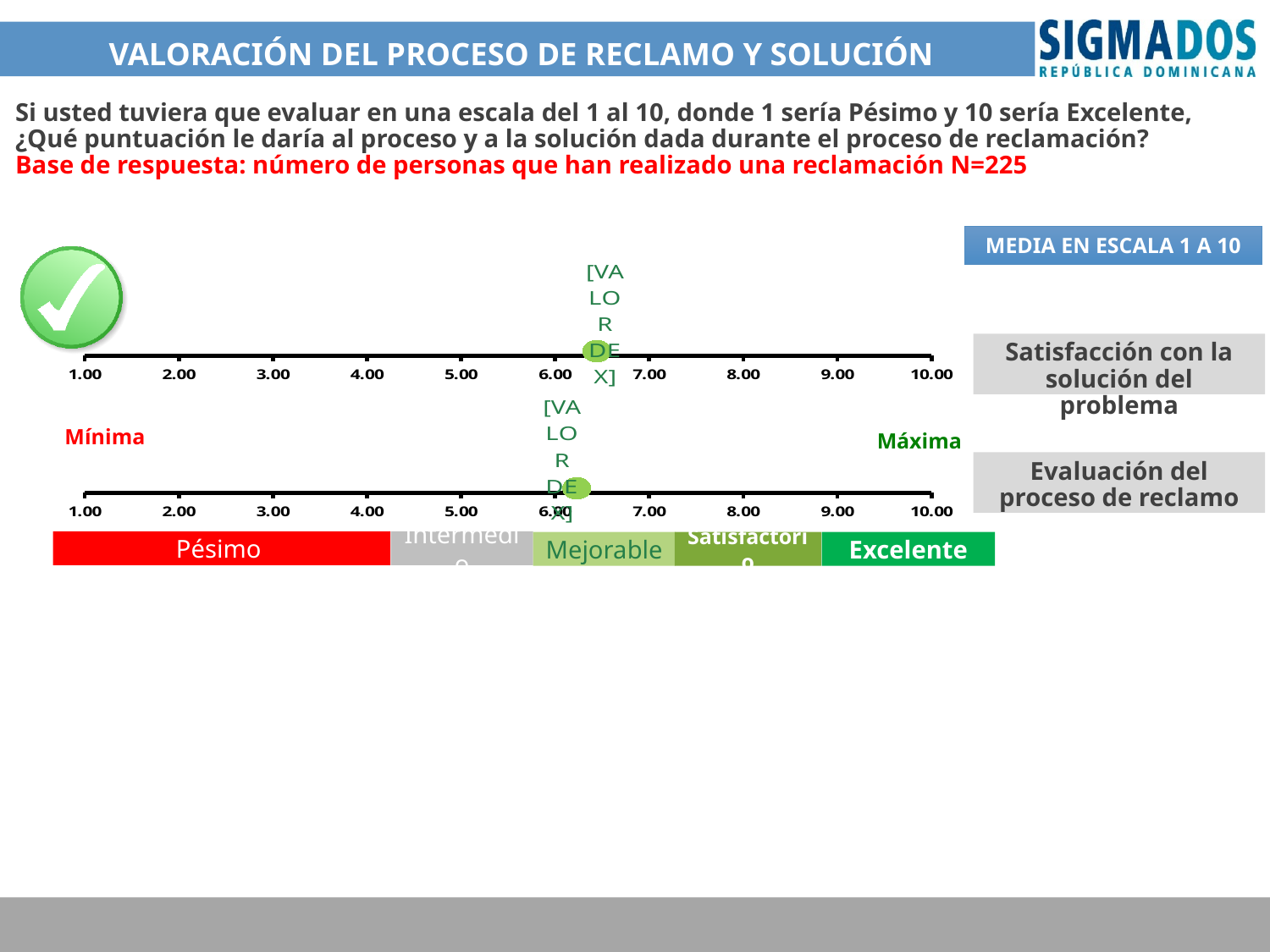
On the bottom chart (Evaluación del proceso de reclamo), is the plotted value greater or less than 8.00? less On the bottom chart (Evaluación del proceso de reclamo), is the plotted value greater or less than 7.00? less What is the highest value labelled on the x axis of the top chart? 10.00 How many plotted points does the top chart show? 1 On the top chart (Satisfacción con la solución del problema), is the plotted value greater or less than 6.00? greater How many plotted points does the bottom chart show? 1 How many tick marks are labelled on the x axis of the top chart? 10 What is the lowest value labelled on the x axis of the bottom chart? 1.00